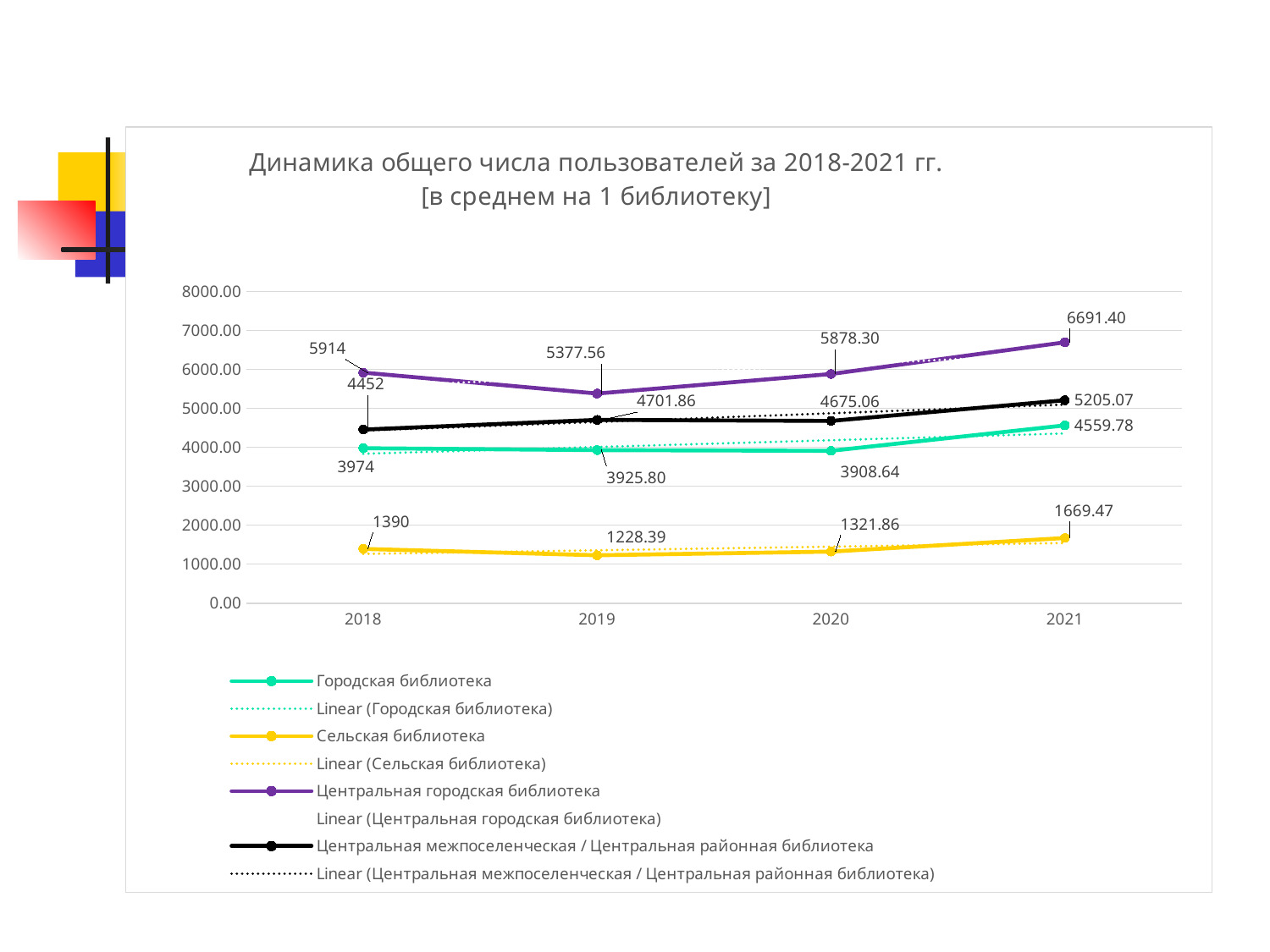
What is the value for Городская библиотека in 2018? 3974 How many entries does the legend list? 8 What is the difference between the 2021 and 2018 values for Городская библиотека? 585.78 Does the value for Сельская библиотека rise or fall from 2020 to 2021? rise How many years are shown on the x axis? 4 In which year is the value for Сельская библиотека the highest? 2021 What is the value for Центральная межпоселенческая / Центральная районная библиотека in 2020? 4675.06 What is the value for Центральная городская библиотека in 2021? 6691.40 What type of chart is shown on the slide? line chart What is the value for Сельская библиотека in 2019? 1228.39 Which is larger in 2019: the value for Центральная межпоселенческая / Центральная районная библиотека or the value for Городская библиотека? Центральная межпоселенческая / Центральная районная библиотека In which year is the value for Центральная городская библиотека the lowest? 2019